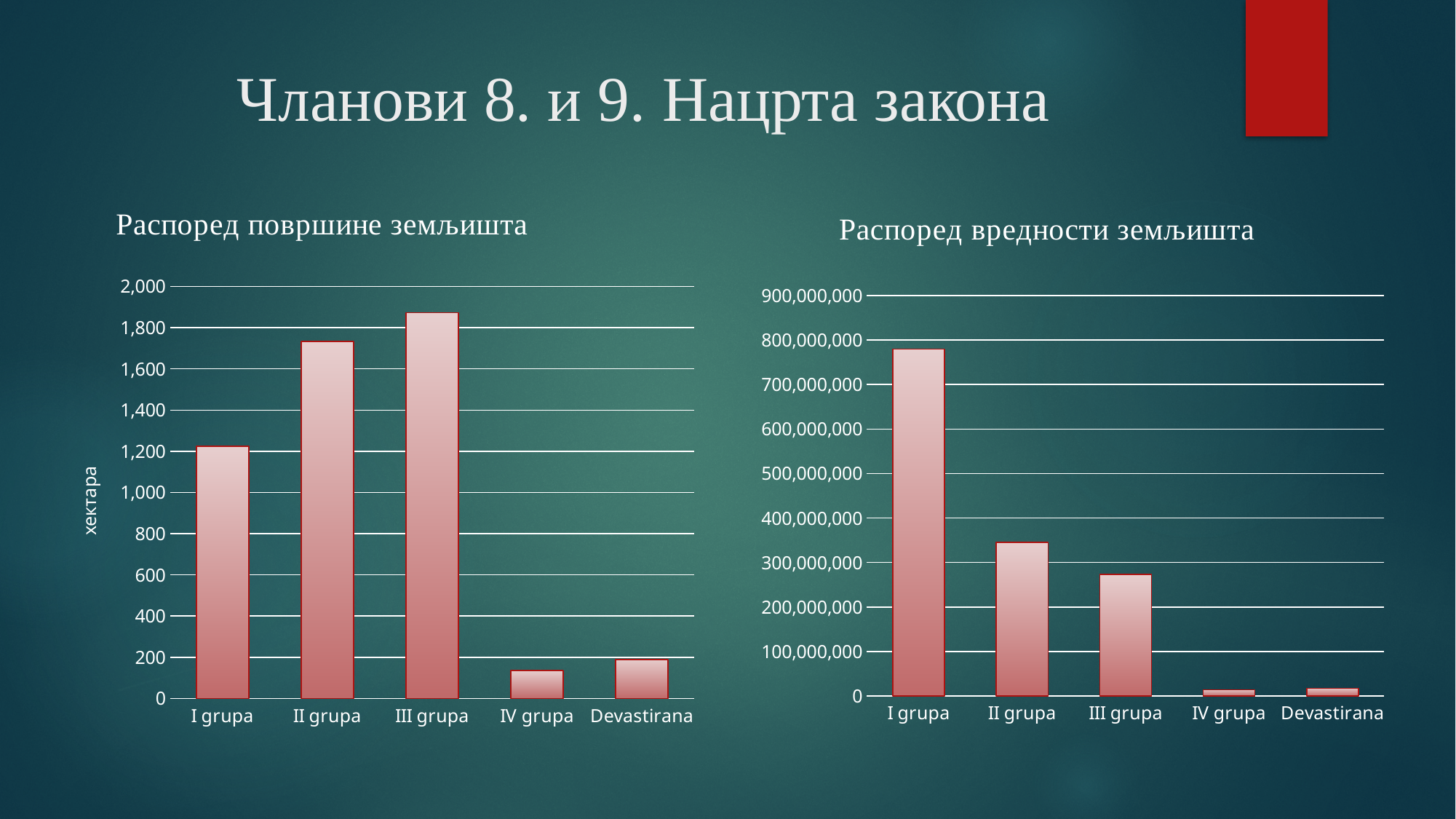
What kind of chart is the chart titled "Распоред површине земљишта"? bar chart In the chart titled "Распоред вредности земљишта", is the value for III grupa greater or less than 300,000,000? less In the chart titled "Распоред вредности земљишта", is the value for II grupa greater or less than 300,000,000? greater What is the y-axis label of the chart titled "Распоред површине земљишта"? хектара In the chart titled "Распоред површине земљишта", which is larger, the value for I grupa or the value for II grupa? II grupa In the chart titled "Распоред вредности земљишта", which category has the highest value? I grupa In the chart titled "Распоред површине земљишта", which category has the highest value? III grupa In the chart titled "Распоред површине земљишта", is the value for Devastirana greater or less than 400? less In the chart titled "Распоред површине земљишта", which category has the lowest value? IV grupa How many categories are shown on the x axis of the chart titled "Распоред вредности земљишта"? 5 In the chart titled "Распоред вредности земљишта", which is larger, the value for II grupa or the value for III grupa? II grupa